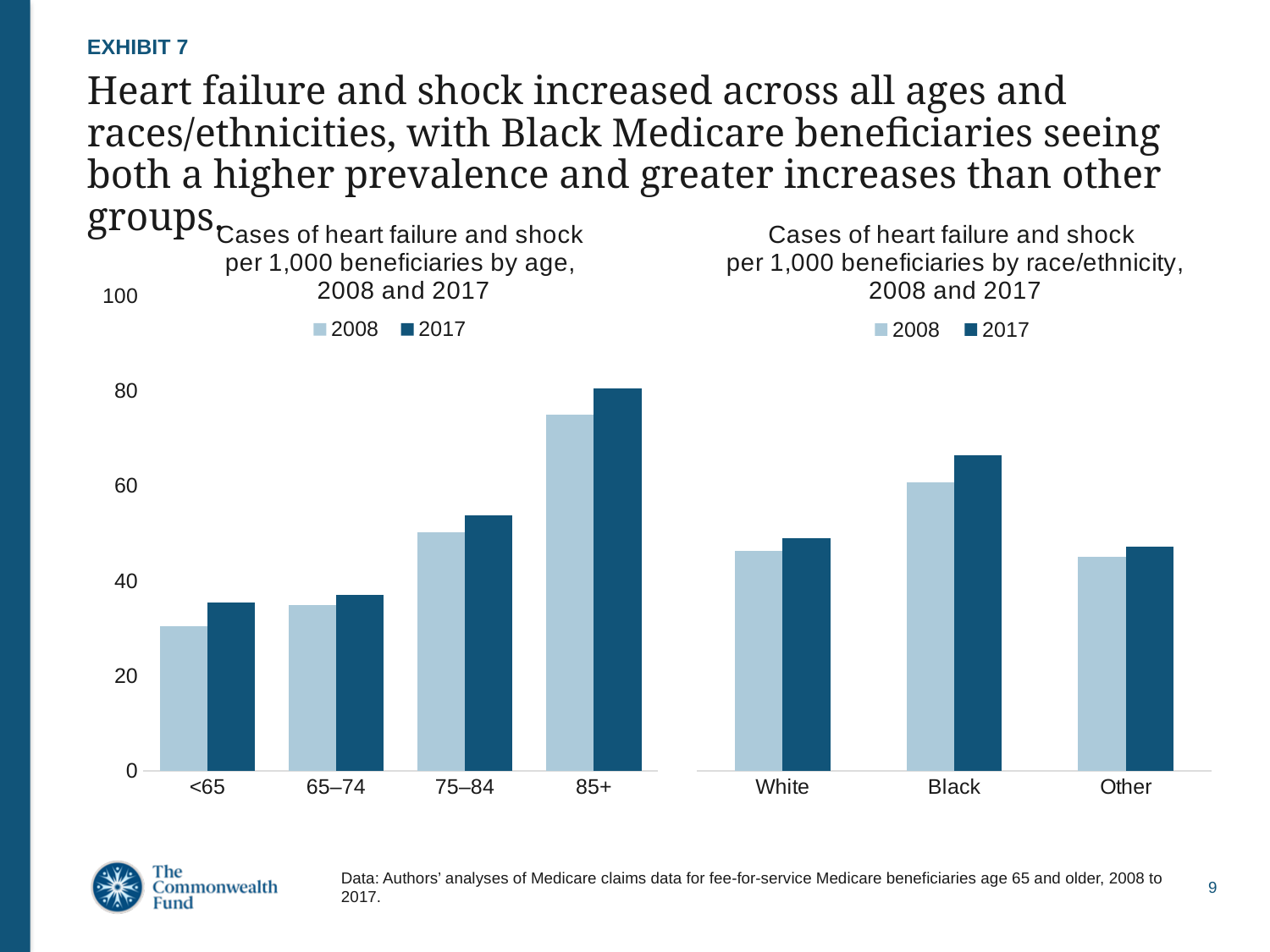
On the right chart (cases by race/ethnicity), is the 2017 value for Black greater or less than 60? greater On the left chart (cases by age), is the 2008 value for <65 greater or less than 40? less What kind of chart is the left chart (cases by age)? bar chart How many age groups are shown on the left chart (cases by age)? 4 On the left chart (cases by age), is the 2017 value for 85+ greater or less than 60? greater On the left chart (cases by age), which age group has the lowest value for 2008? <65 On the left chart (cases by age), which age group has the highest value for 2017? 85+ On the left chart (cases by age), do the 2017 values rise or fall as the age groups go from <65 to 85+? rise On the right chart (cases by race/ethnicity), which group has the highest value for 2008? Black On the right chart (cases by race/ethnicity), which is larger: the 2017 value for Black or the 2017 value for White? Black How many series does the legend of the right chart (cases by race/ethnicity) list? 2